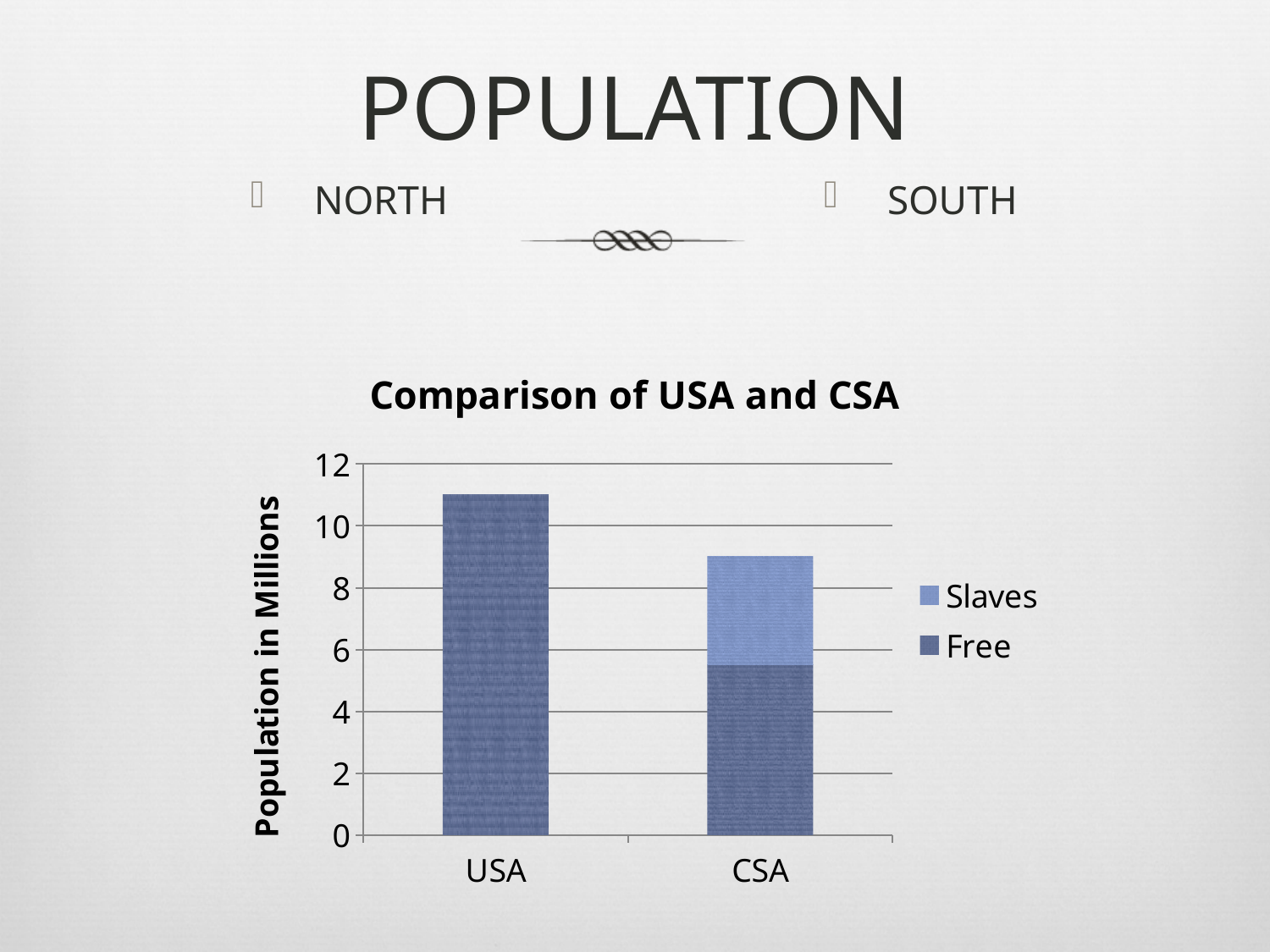
How many series does the chart's legend list? 2 Is the Free value for CSA greater or less than 6? less Which category has the shorter total bar? CSA Within the CSA bar, which segment is larger, Free or Slaves? Free What is the title of the chart? Comparison of USA and CSA What kind of chart is shown on the slide? Stacked bar chart How many categories are shown on the x axis of the chart? 2 Which category has the taller total bar, USA or CSA? USA What is the label on the vertical axis of the chart? Population in Millions Is the total value for CSA greater or less than 10? less Is the total value for USA greater or less than 10? greater